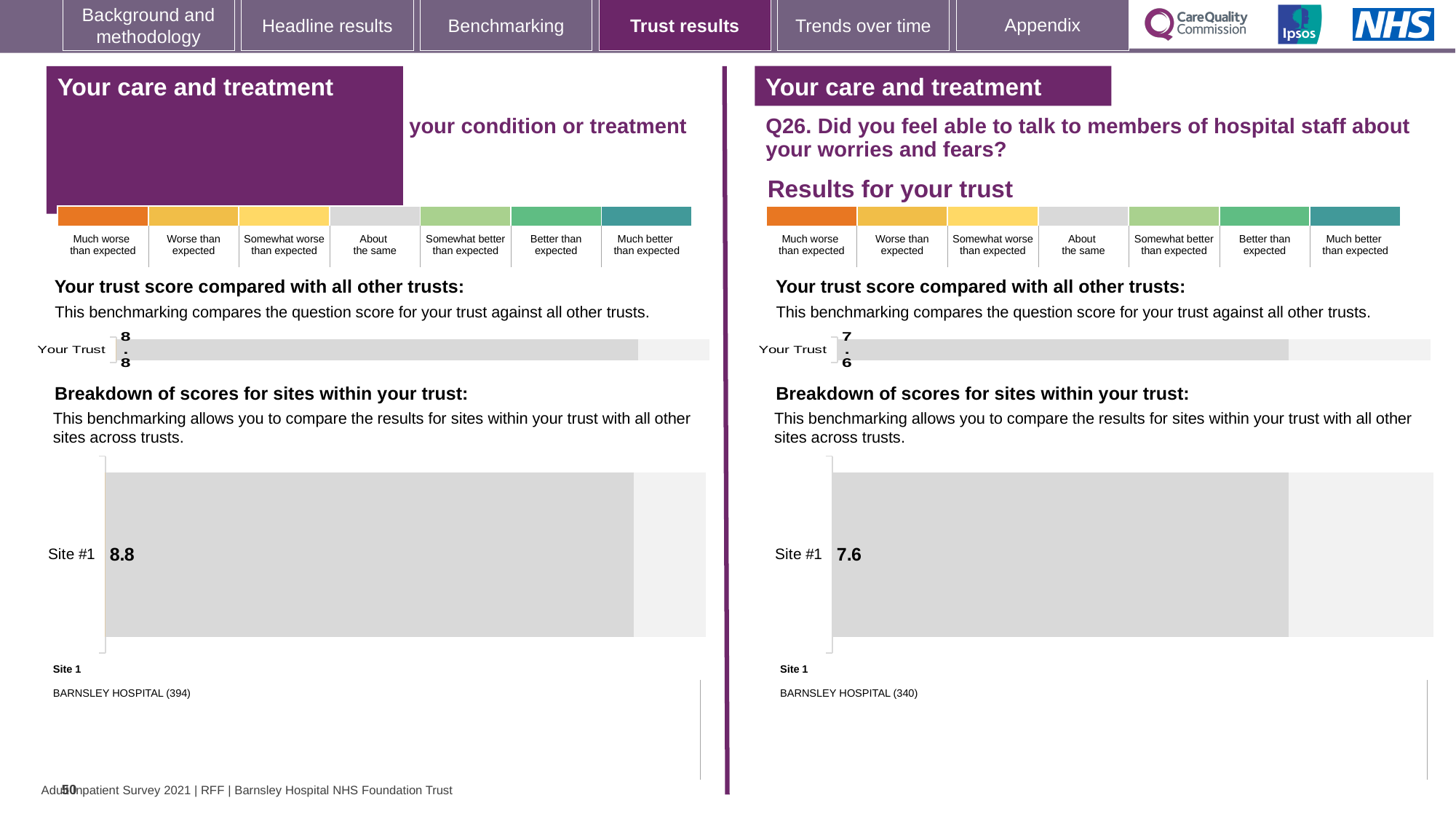
On the right-hand (Q26) 'Breakdown of scores for sites within your trust' chart, what is the score for Site #1? 7.6 On the left-hand 'Your trust score compared with all other trusts' chart, what is the value for Your Trust? 8.8 Which is larger: the Site #1 score on the left-hand breakdown chart or the Site #1 score on the right-hand (Q26) breakdown chart? Left-hand chart (8.8) How many sites are shown on the left-hand 'Breakdown of scores for sites within your trust' chart? 1 How many categories does the colour scale above the left-hand charts show, from 'Much worse than expected' to 'Much better than expected'? 7 Which site name is listed under Site 1 on the right-hand (Q26) breakdown chart? BARNSLEY HOSPITAL (340) What is the difference between the Your Trust score on the left-hand chart and the Your Trust score on the right-hand (Q26) chart? 1.2 What type of chart is used to show the Site #1 score on the right-hand (Q26) breakdown chart? Bar chart How many sites are shown on the right-hand (Q26) 'Breakdown of scores for sites within your trust' chart? 1 On the right-hand (Q26) 'Your trust score compared with all other trusts' chart, what is the value for Your Trust? 7.6 On the left-hand 'Breakdown of scores for sites within your trust' chart, what is the score for Site #1? 8.8